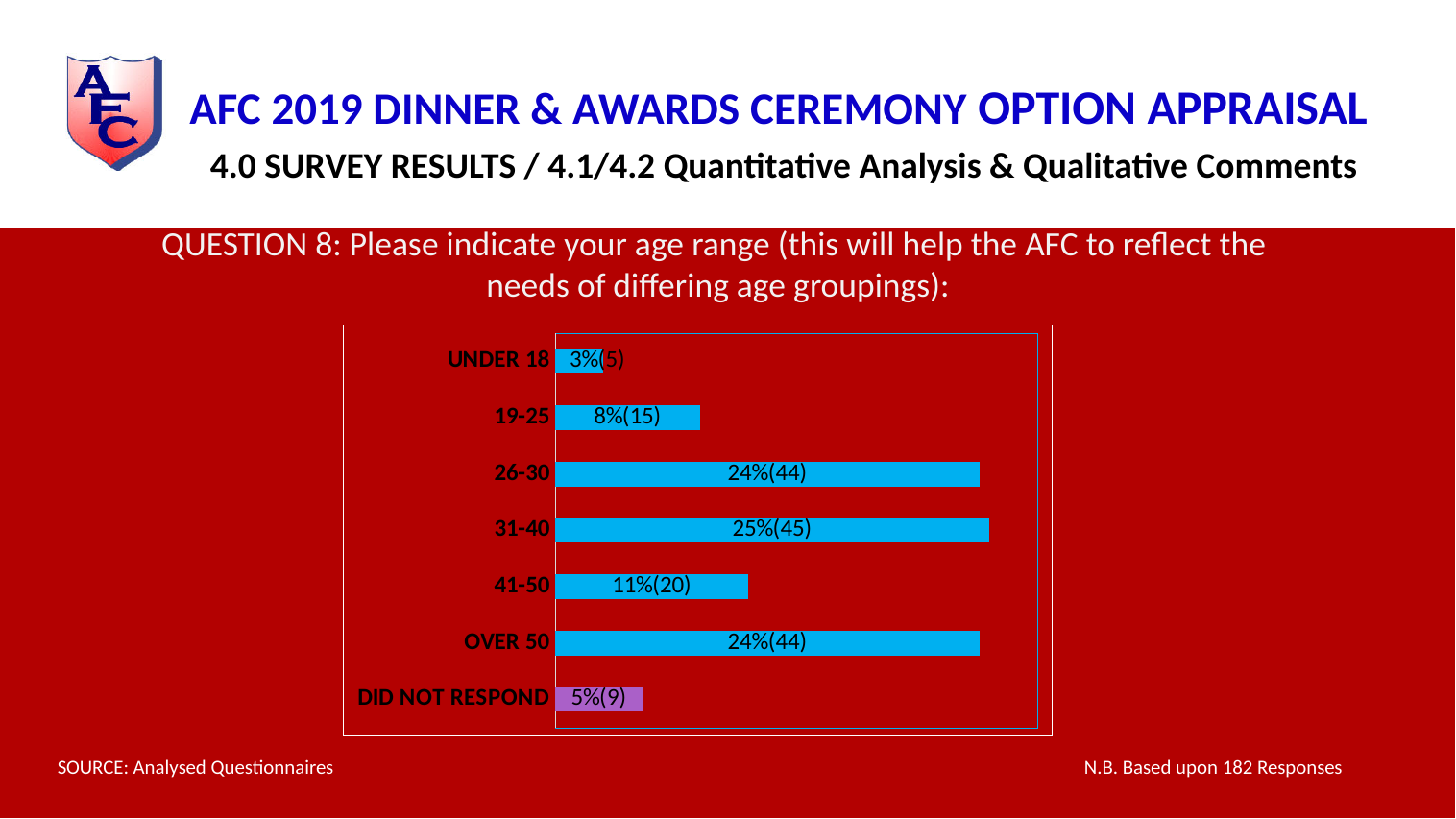
How many categories are shown in the chart? 7 What is the value shown for the 26-30 age range? 24%(44) Which category's bar is coloured differently (purple) from the others? DID NOT RESPOND What kind of chart is shown on the slide? Bar chart How many respondents are in the DID NOT RESPOND category? 9 Which is larger, the value for 19-25 or the value for 41-50? 41-50 What is the difference in number of respondents between the 19-25 and 41-50 age ranges? 5 Which category has the lowest value? UNDER 18 What is the value shown for the 41-50 age range? 11%(20) What is the percentage shown for the OVER 50 age range? 24% Which age range has the highest value? 31-40 What is the value shown for the UNDER 18 category? 3%(5)